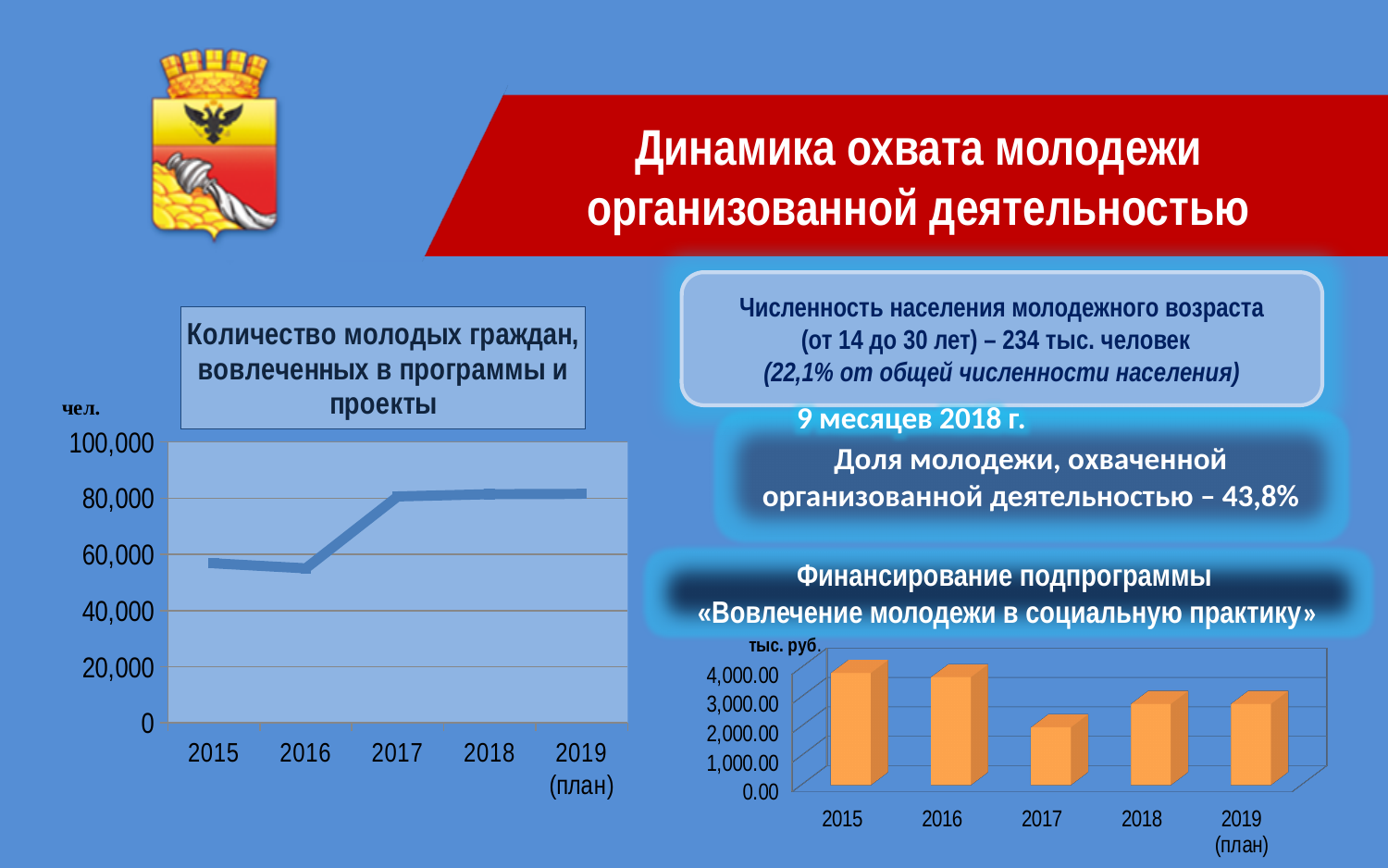
What kind of chart is the chart titled «Количество молодых граждан, вовлеченных в программы и проекты»? line chart What kind of chart is the chart titled «Финансирование подпрограммы «Вовлечение молодежи в социальную практику»»? bar chart In the chart «Количество молодых граждан, вовлеченных в программы и проекты», is the value for 2017 greater or less than 60,000? greater In the chart «Количество молодых граждан, вовлеченных в программы и проекты», do the values overall rise or fall from 2015 to 2019 (план)? rise In the chart «Количество молодых граждан, вовлеченных в программы и проекты», is the value for 2018 greater or less than 100,000? less How many years are shown on the x axis of the chart «Количество молодых граждан, вовлеченных в программы и проекты»? 5 In the chart «Количество молодых граждан, вовлеченных в программы и проекты», is the value for 2016 greater or less than 60,000? less What unit is shown on the vertical axis of the chart «Финансирование подпрограммы «Вовлечение молодежи в социальную практику»»? тыс. руб. How many bars are in the chart «Финансирование подпрограммы «Вовлечение молодежи в социальную практику»»? 5 In the chart «Финансирование подпрограммы «Вовлечение молодежи в социальную практику»», which year has the highest bar? 2015 In the chart «Финансирование подпрограммы «Вовлечение молодежи в социальную практику»», which year has the lowest bar? 2017